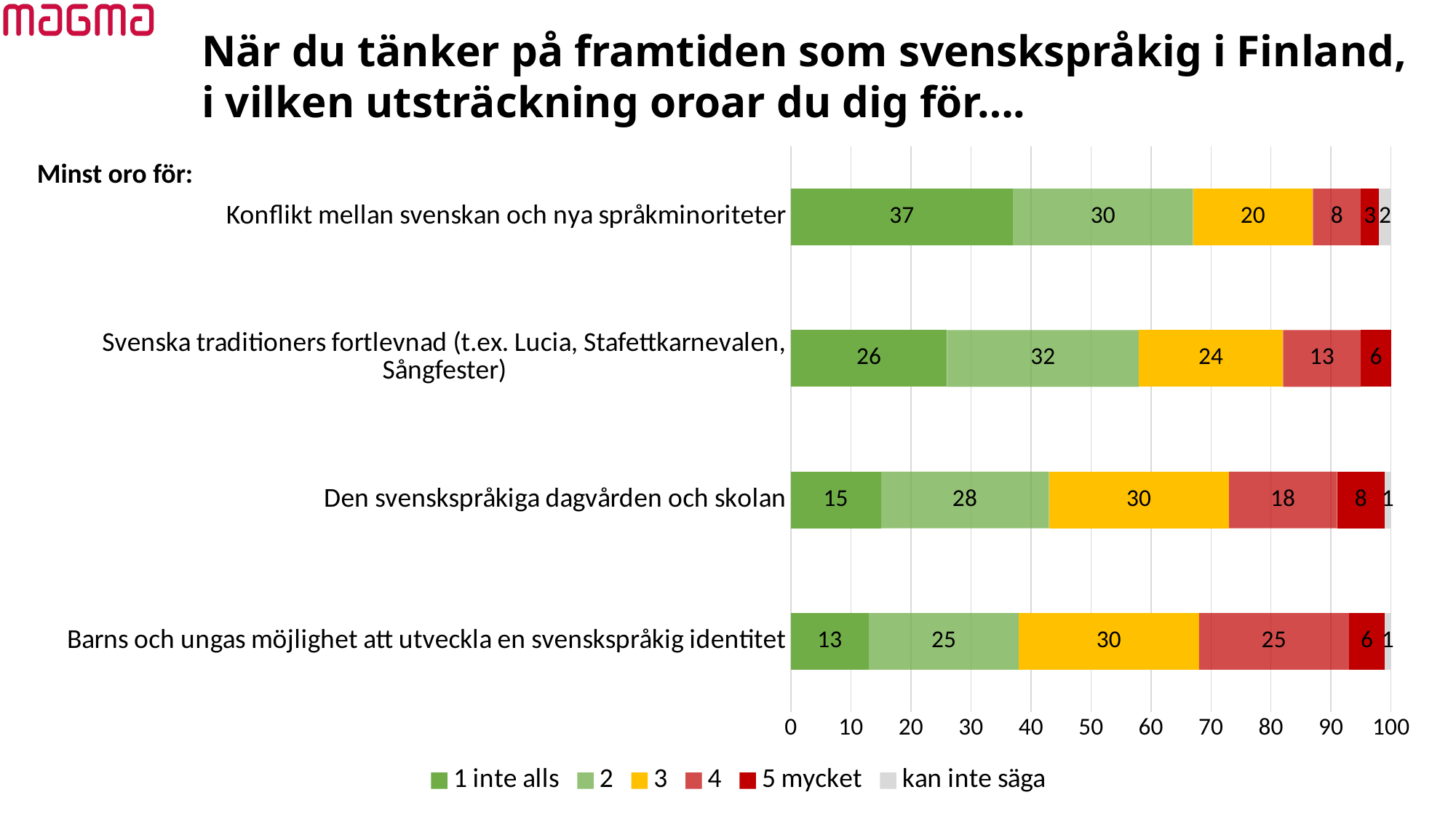
What kind of chart is shown on the slide? stacked bar chart Which legend entry is shown in grey? kan inte säga How many categories (statements) are plotted on the chart? 4 What is the value of '1 inte alls' for 'Konflikt mellan svenskan och nya språkminoriteter'? 37 What is the value of '5 mycket' for 'Den svenskspråkiga dagvården och skolan'? 8 What is the value of '2' for 'Svenska traditioners fortlevnad (t.ex. Lucia, Stafettkarnevalen, Sångfester)'? 32 How many series does the legend list? 6 What is the value of '4' for 'Barns och ungas möjlighet att utveckla en svenskspråkig identitet'? 25 Which category has the lowest value for '1 inte alls'? Barns och ungas möjlighet att utveckla en svenskspråkig identitet Which is larger: the '3' value for 'Den svenskspråkiga dagvården och skolan' or the '3' value for 'Konflikt mellan svenskan och nya språkminoriteter'? Den svenskspråkiga dagvården och skolan What is the difference between the '4' values for 'Barns och ungas möjlighet att utveckla en svenskspråkig identitet' and 'Konflikt mellan svenskan och nya språkminoriteter'? 17 Which category has the highest value for '1 inte alls'? Konflikt mellan svenskan och nya språkminoriteter